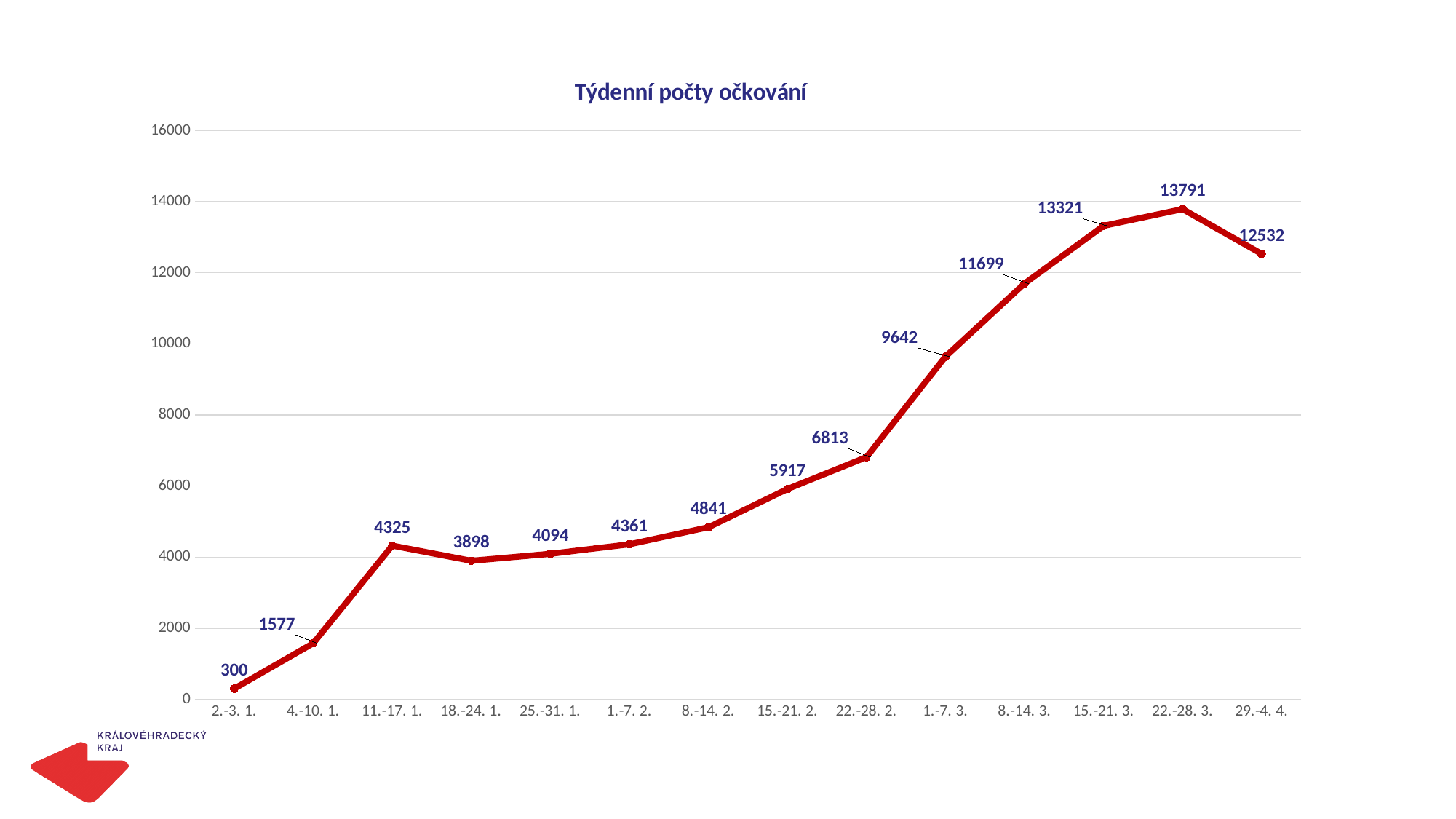
How many weeks are plotted on the chart? 14 What is the difference between the values for 22.-28. 3. and 29.-4. 4.? 1259 What is the value for the week 2.-3. 1.? 300 Which is larger, the value for 11.-17. 1. or the value for 18.-24. 1.? 11.-17. 1. Which week has the lowest value? 2.-3. 1. What is the difference between the values for 1.-7. 3. and 22.-28. 2.? 2829 What is the title of the chart? Týdenní počty očkování Which week has the highest value? 22.-28. 3. What is the value for the week 15.-21. 2.? 5917 What kind of chart is shown? line chart Do the values generally rise or fall from 2.-3. 1. to 22.-28. 3.? rise What is the value for the week 22.-28. 3.? 13791